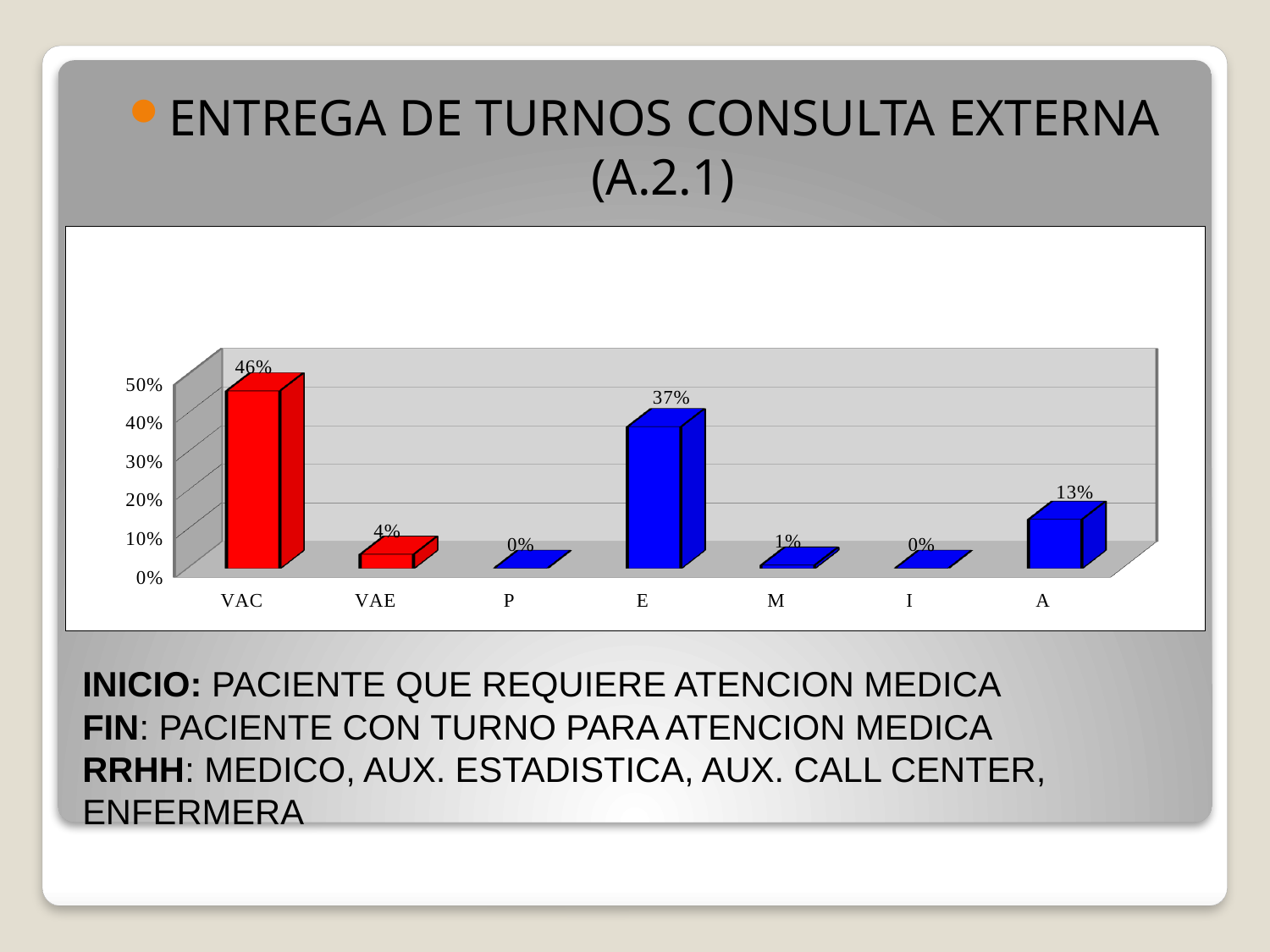
What kind of chart is shown on the slide? bar chart Is the value for E greater or less than 30%? greater What is the value for VAE? 4% How many categories are shown on the x axis? 7 What is the difference between the values for VAC and E? 9% What is the value for E? 37% Which is larger, the value for E or the value for A? E What is the value for VAC? 46% Which category has the highest value? VAC What is the difference between the values for A and VAE? 9% What colour is the bar for VAC? red What is the value for A? 13%